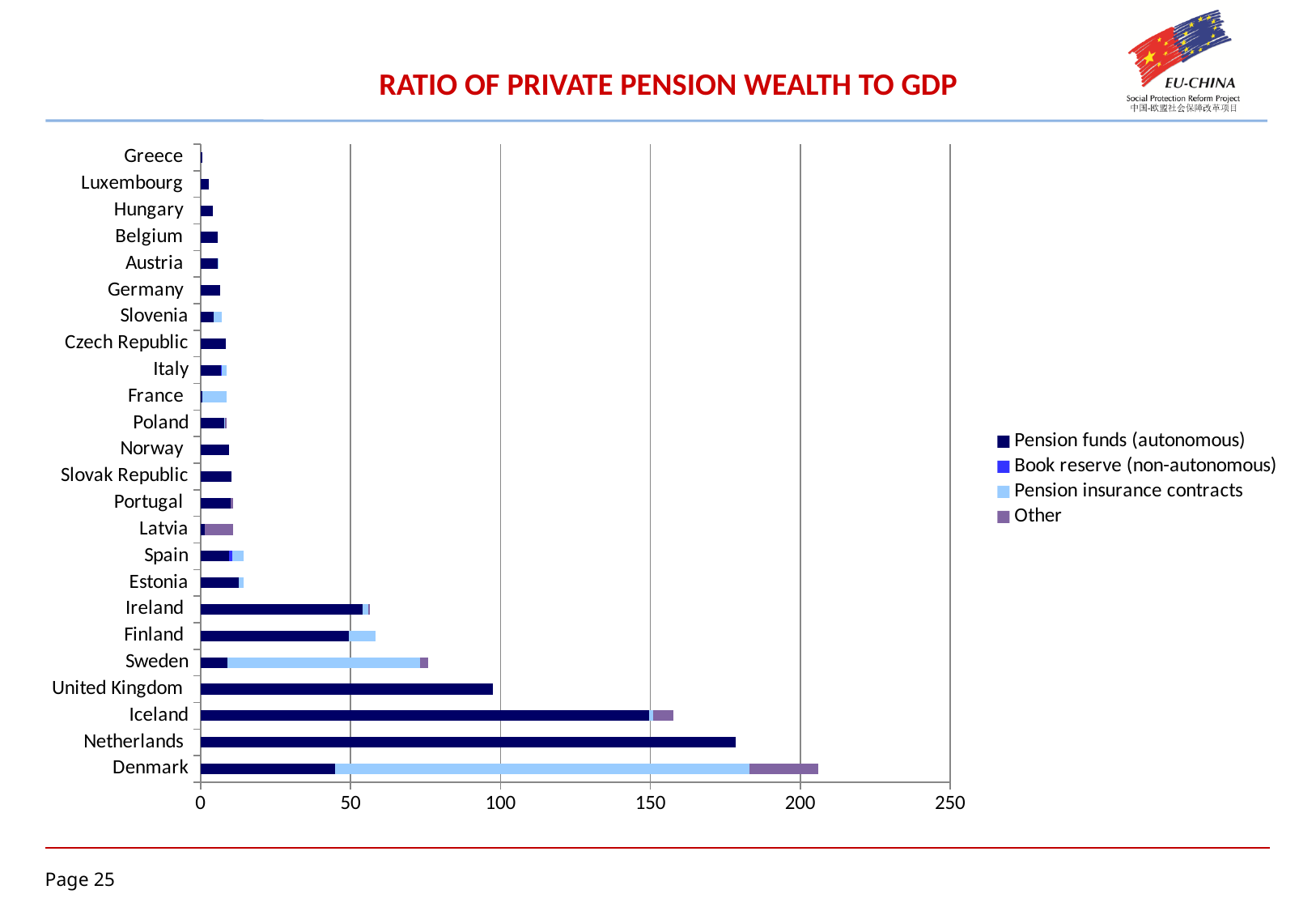
How many countries are listed on the chart? 24 Is the total value for Estonia greater or less than 50? less Which has the larger total bar, Netherlands or United Kingdom? Netherlands What kind of chart is shown on the slide? Bar chart What is the title of the chart? RATIO OF PRIVATE PENSION WEALTH TO GDP Which country has the shortest total bar? Greece Is the total value for Sweden greater or less than 50? greater How many series does the legend list? 4 Is the total value for Denmark greater or less than 200? greater Which country has the longest total bar? Denmark Which has the larger total bar, Sweden or Finland? Sweden